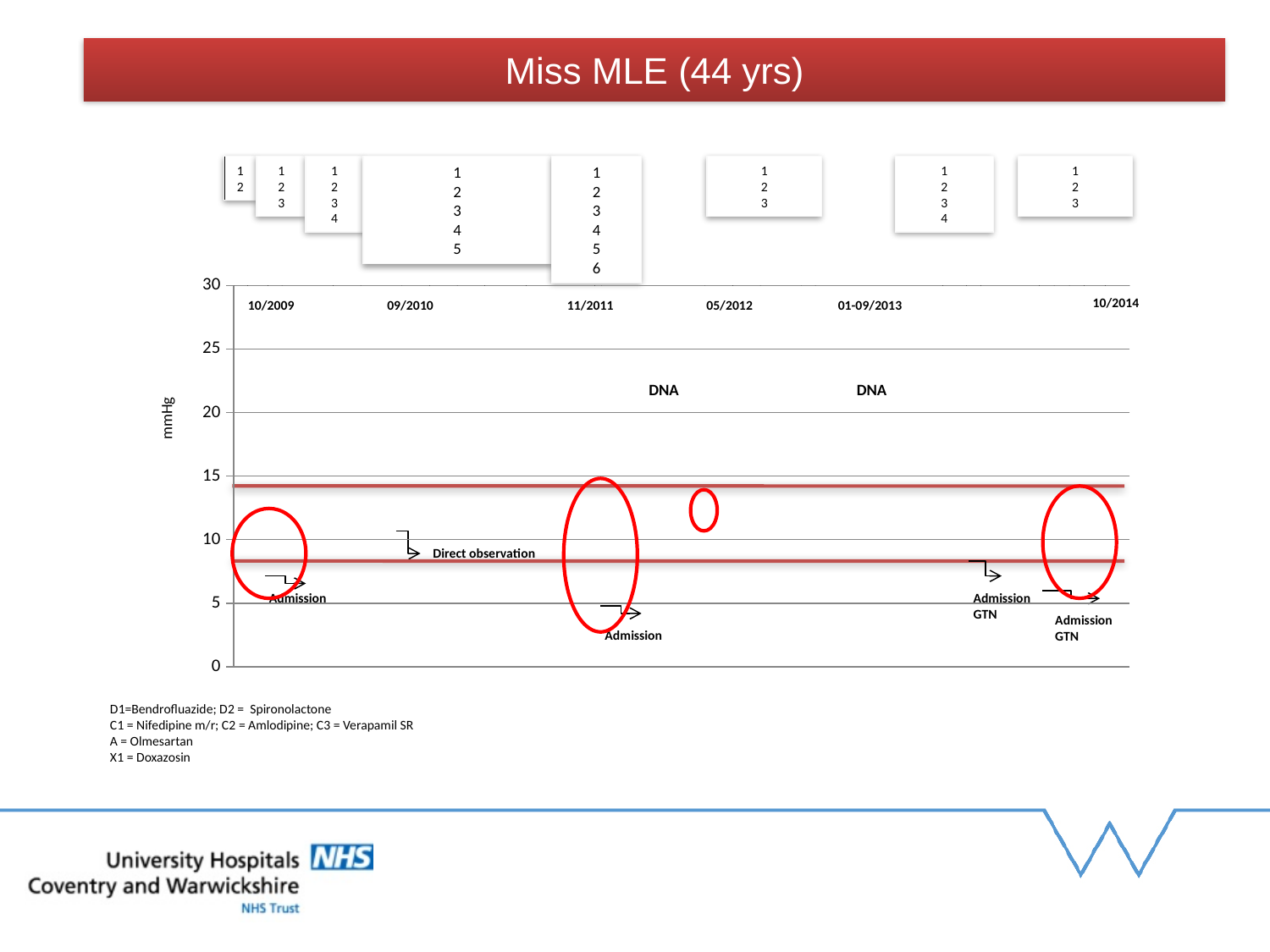
What is the label on the y axis of the chart? mmHg What is the first date label shown on the chart? 10/2009 How many date labels are shown along the top of the chart's plot area? 6 Which date label on the chart is annotated with "Direct observation"? 09/2010 How many times does the annotation "Admission" appear on the chart? 4 What is the last date label shown on the chart? 10/2014 What is the highest value shown on the y axis of the chart? 30 Is the lower horizontal red line on the chart greater or less than 5 mmHg? greater Is the upper horizontal red line on the chart greater or less than 10 mmHg? greater How many times does the annotation "DNA" appear on the chart? 2 Is the upper horizontal red line on the chart greater or less than 15 mmHg? less